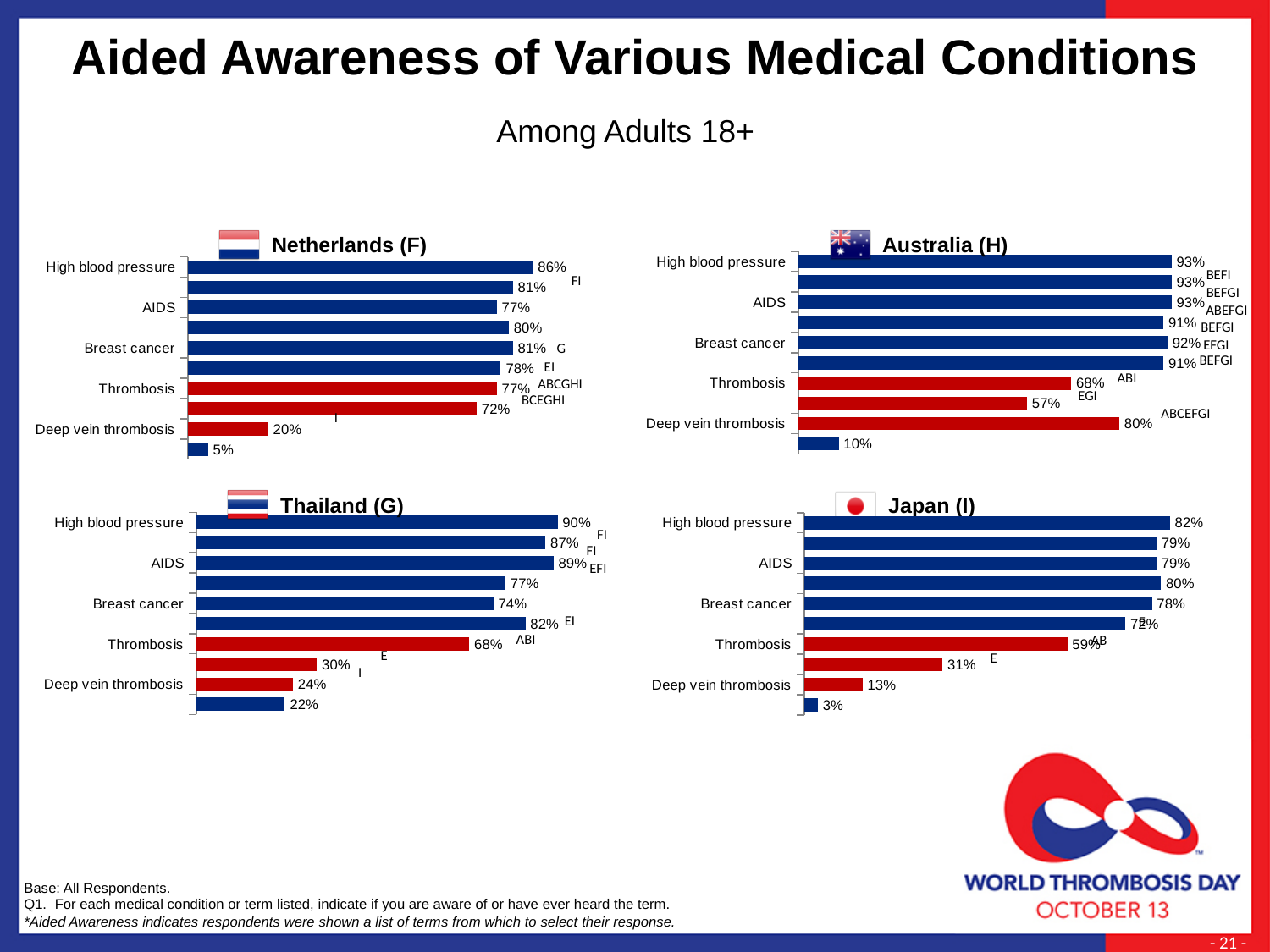
In the Netherlands (F) chart, what is the value for High blood pressure? 86% In the Australia (H) chart, what is the value for Thrombosis? 68% In the Japan (I) chart, what is the value for Thrombosis? 59% In the Japan (I) chart, what is the difference between the values for High blood pressure and Deep vein thrombosis? 69% In the Netherlands (F) chart, which is larger, the value for Breast cancer or the value for AIDS? Breast cancer In the Australia (H) chart, which is larger, the value for Deep vein thrombosis or the value for Thrombosis? Deep vein thrombosis In the Netherlands (F) chart, what is the value for Deep vein thrombosis? 20% In the Australia (H) chart, what is the value for Deep vein thrombosis? 80% How many charts are shown on the slide? 4 What kind of chart is the Japan (I) chart? Bar chart In the Thailand (G) chart, what is the value for Breast cancer? 74% In the Thailand (G) chart, what is the difference between the values for AIDS and Thrombosis? 21%